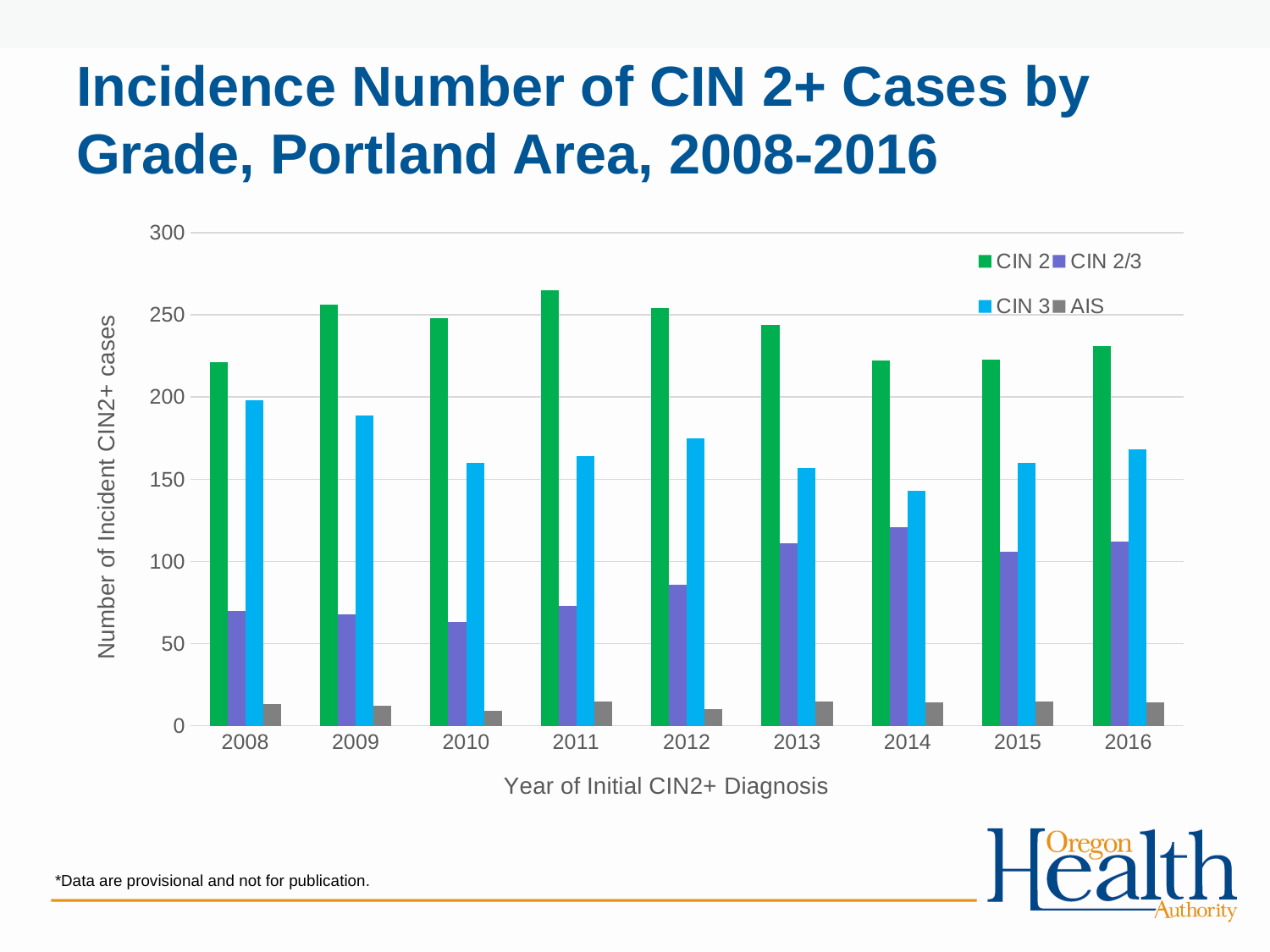
In 2008, which is larger: CIN 2 or CIN 3? CIN 2 Is the CIN 2 value for 2011 greater or less than 250? greater What kind of chart is shown on the slide? bar chart In which year is the CIN 2 value highest? 2011 In which year is the CIN 3 value highest? 2008 Is the CIN 3 value for 2014 greater or less than 150? less Which series has the lowest value in every year? AIS How many series does the legend list? 4 How many years are shown on the x axis? 9 In which year is the CIN 3 value lowest? 2014 Is the CIN 2/3 value for 2014 greater or less than 100? greater In which year is the CIN 2/3 value highest? 2014